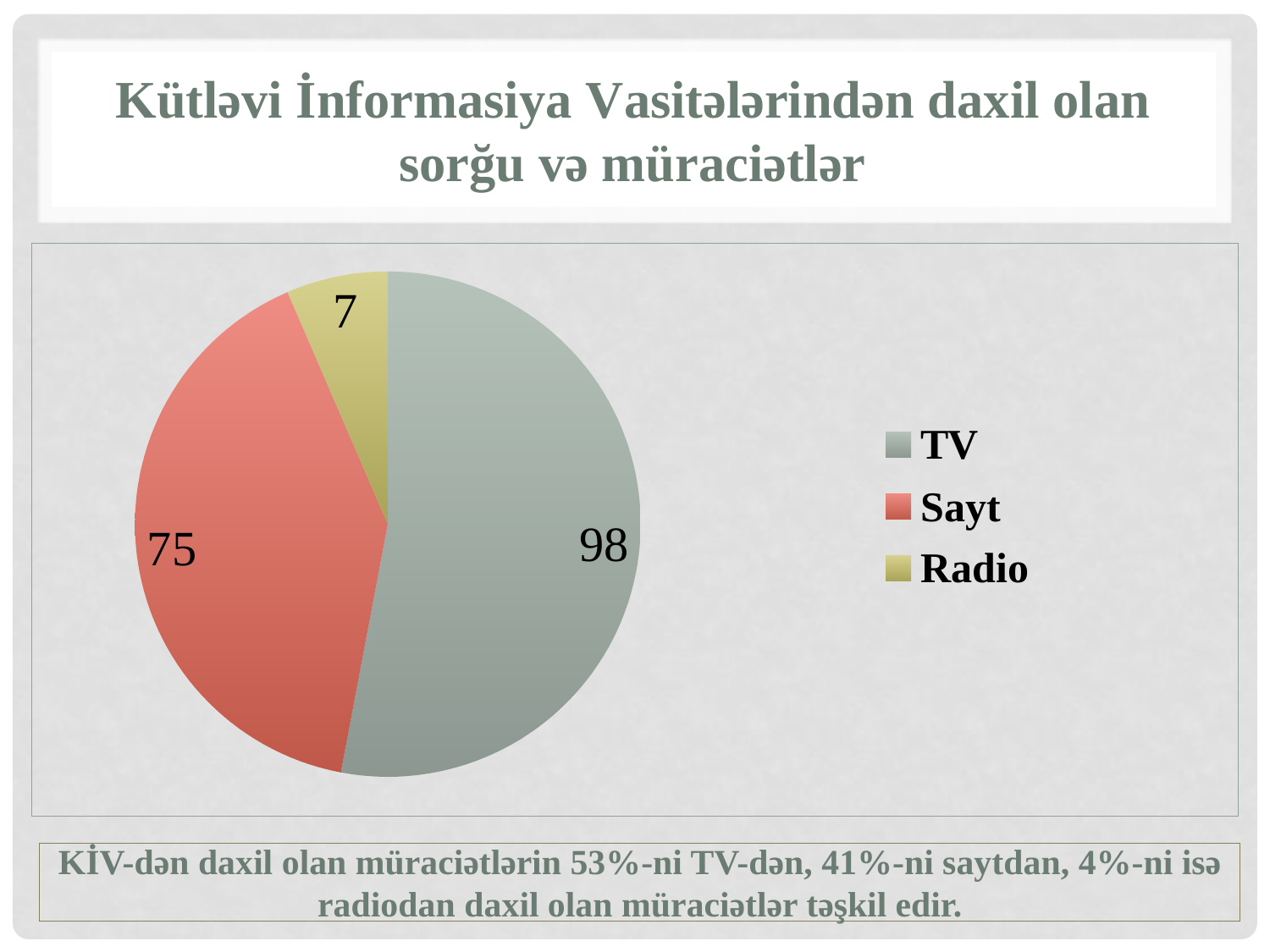
What type of chart is shown on the slide? pie chart What is the value for TV in the pie chart? 98 Which is larger, the value for Sayt or the value for Radio? Sayt What is the value for Radio in the pie chart? 7 What is the total of all the values shown in the pie chart? 180 What is the difference between the values for TV and Sayt? 23 How many categories does the pie chart show? 3 Which colour represents Sayt in the pie chart? red Which category has the largest slice in the pie chart? TV Which category has the smallest slice in the pie chart? Radio What is the value for Sayt in the pie chart? 75 What is the difference between the values for Sayt and Radio? 68